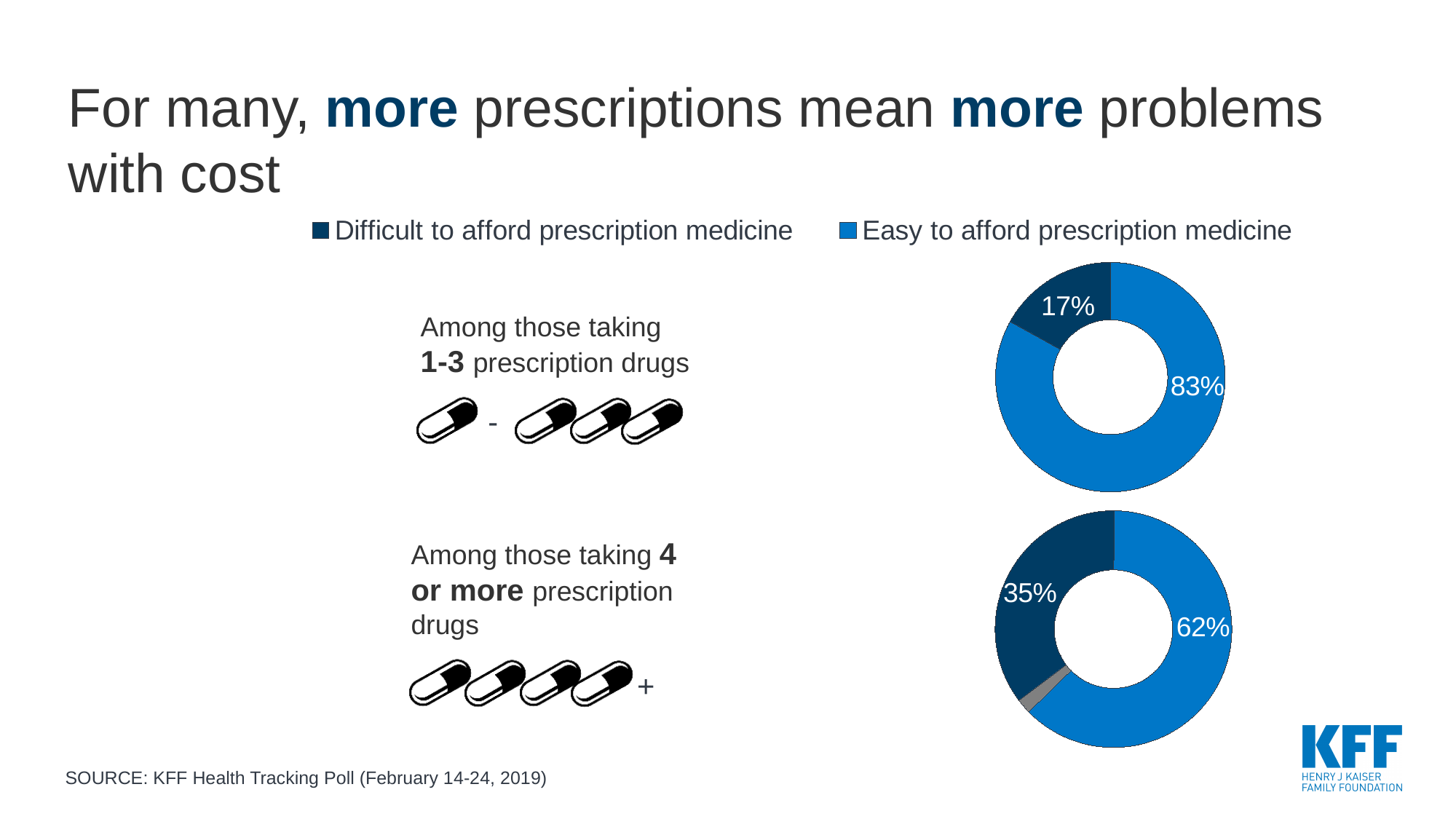
In the bottom donut chart (4 or more prescription drugs), which is larger: the share finding it difficult or the share finding it easy to afford prescription medicine? Easy to afford prescription medicine How many series does the legend list? 2 Which prescription group has the higher share finding it difficult to afford prescription medicine? Those taking 4 or more prescription drugs In the donut chart for those taking 1-3 prescription drugs, what percentage find it difficult to afford prescription medicine? 17% What kind of chart is used to show the shares for each prescription group on this slide? Donut (pie) chart In the top donut chart (1-3 prescription drugs), what is the difference between the 'Easy to afford' and 'Difficult to afford' shares? 66 percentage points In the top donut chart (1-3 prescription drugs), which is larger: the share finding it difficult or the share finding it easy to afford prescription medicine? Easy to afford prescription medicine In the donut chart for those taking 4 or more prescription drugs, what percentage find it difficult to afford prescription medicine? 35% In the donut chart for those taking 4 or more prescription drugs, what percentage find it easy to afford prescription medicine? 62% In the donut chart for those taking 1-3 prescription drugs, what percentage find it easy to afford prescription medicine? 83% What is the difference between the 'Difficult to afford' share for those taking 4 or more prescription drugs and the 'Difficult to afford' share for those taking 1-3 prescription drugs? 18 percentage points Which colour represents 'Difficult to afford prescription medicine' in the legend? Dark blue